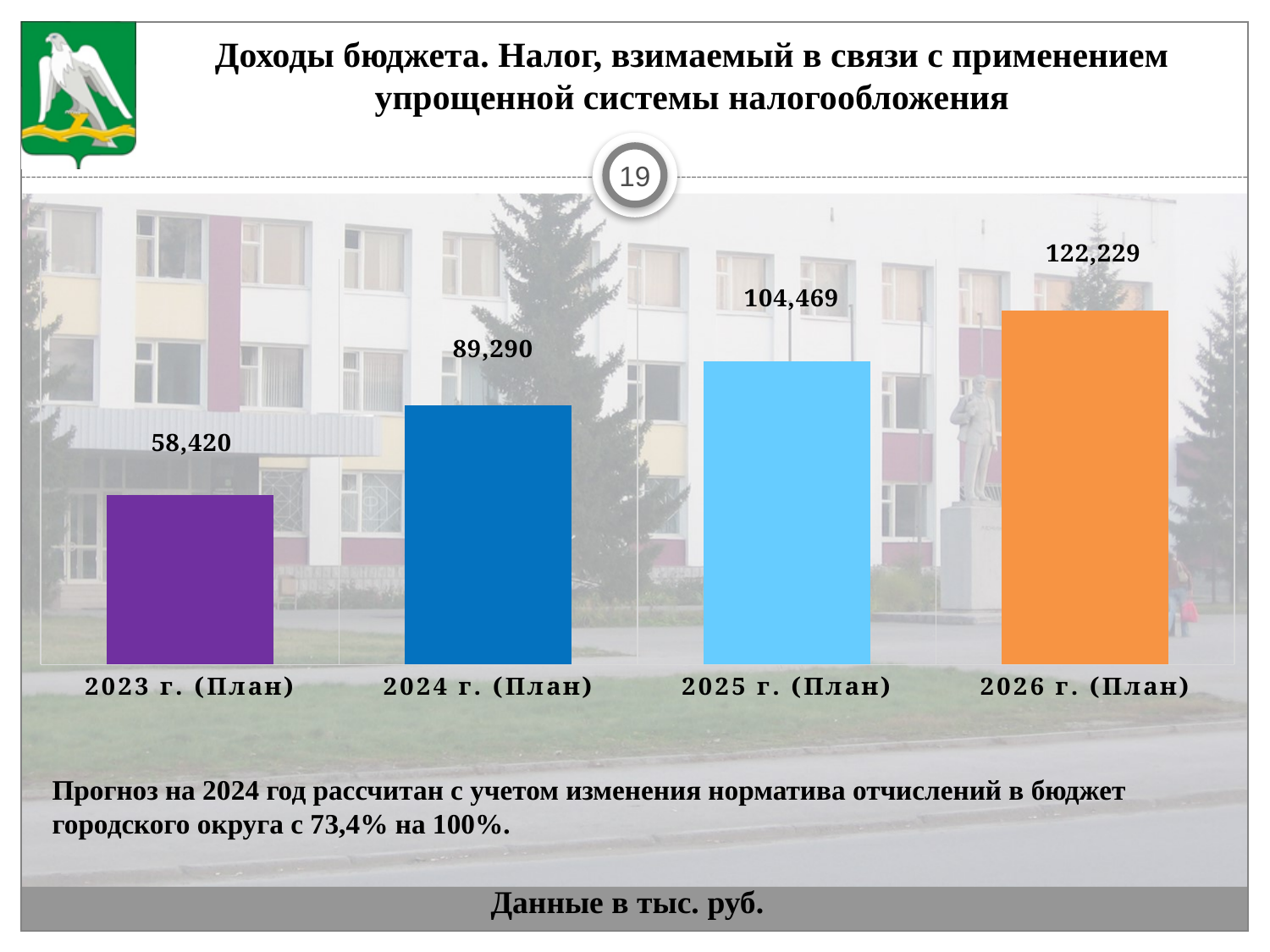
What is the value for 2023 г. (План)? 58,420 What kind of chart is shown on the slide? Bar chart What is the difference between the values for 2024 г. (План) and 2023 г. (План)? 30,870 Which year has the highest value? 2026 г. (План) What is the value for 2024 г. (План)? 89,290 Do the values rise or fall from 2023 to 2026? Rise What is the difference between the values for 2026 г. (План) and 2023 г. (План)? 63,809 Which is larger, the value for 2025 г. (План) or 2024 г. (План)? 2025 г. (План) What is the value for 2026 г. (План)? 122,229 How many bars are shown in the chart? 4 Which year has the lowest value? 2023 г. (План) What is the value for 2025 г. (План)? 104,469